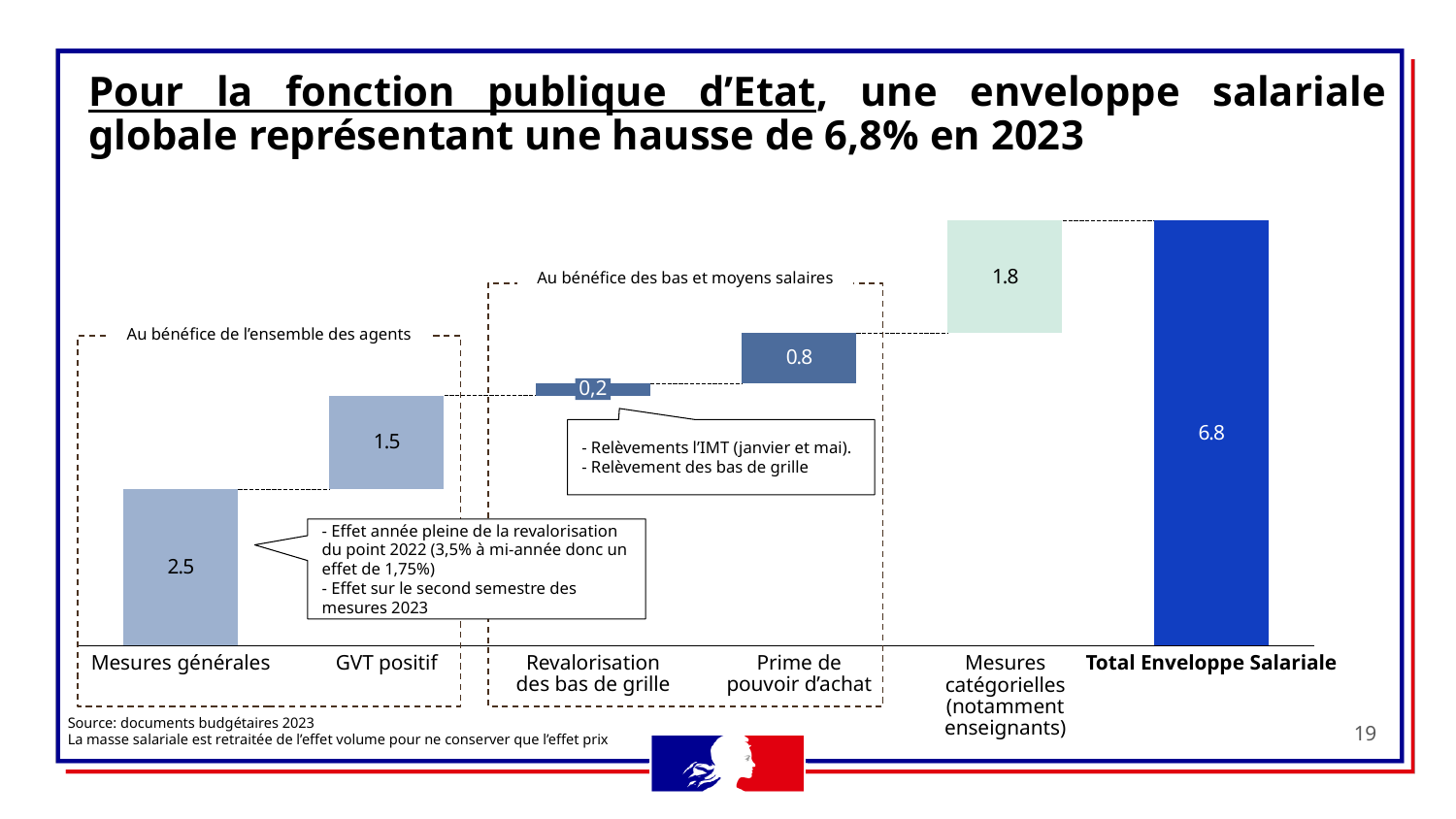
Excluding the total bar, which category has the highest value? Mesures générales Which two categories are grouped under the label 'Au bénéfice de l'ensemble des agents'? Mesures générales and GVT positif What is the value shown for Revalorisation des bas de grille? 0,2 What is the value shown for Mesures catégorielles (notamment enseignants)? 1.8 What is the value shown for Prime de pouvoir d'achat? 0.8 What is the value shown for GVT positif? 1.5 Which category has the lowest value? Revalorisation des bas de grille What is the value shown for Mesures générales? 2.5 What is the difference between the values for Mesures générales and GVT positif? 1 Which is larger, the value for GVT positif or the value for Mesures catégorielles (notamment enseignants)? Mesures catégorielles (notamment enseignants) What is the value of the Total Enveloppe Salariale bar? 6.8 How many categories are shown on the x axis, including the total? 6